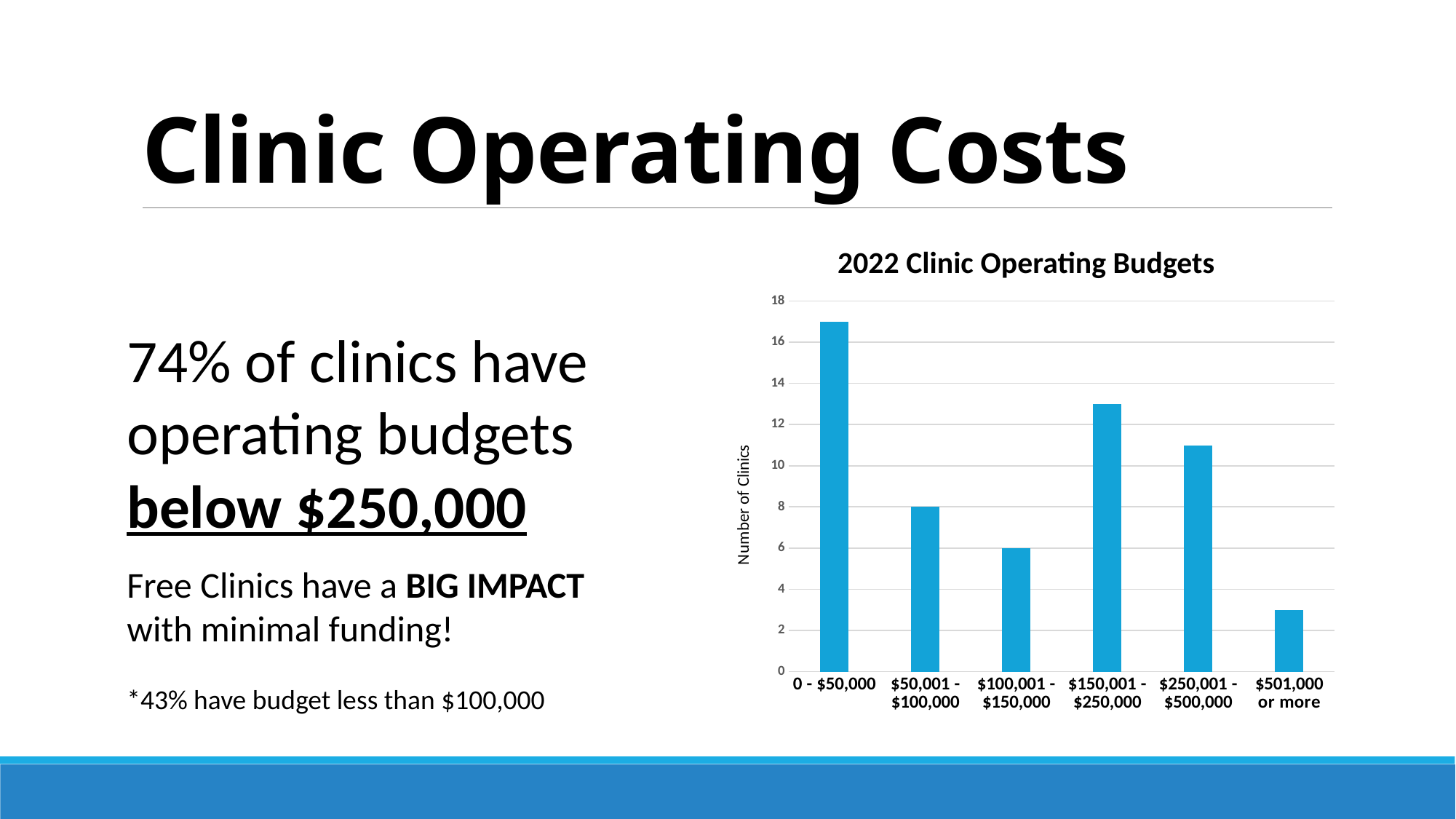
Which budget category has the highest number of clinics? 0 - $50,000 What is the difference between the number of clinics in the $50,001 - $100,000 category and the $100,001 - $150,000 category? 2 How many clinics have an operating budget of $100,001 - $150,000? 6 What is the title of the chart? 2022 Clinic Operating Budgets Is the number of clinics in the $501,000 or more category greater or less than 4? less Which budget category has the lowest number of clinics? $501,000 or more What is the label on the vertical axis of the chart? Number of Clinics How many clinics have an operating budget of $50,001 - $100,000? 8 How many budget categories are shown on the x axis of the chart? 6 Is the number of clinics in the 0 - $50,000 category greater or less than 16? greater What type of chart is shown on the slide? Bar chart Which category has more clinics: $150,001 - $250,000 or $250,001 - $500,000? $150,001 - $250,000